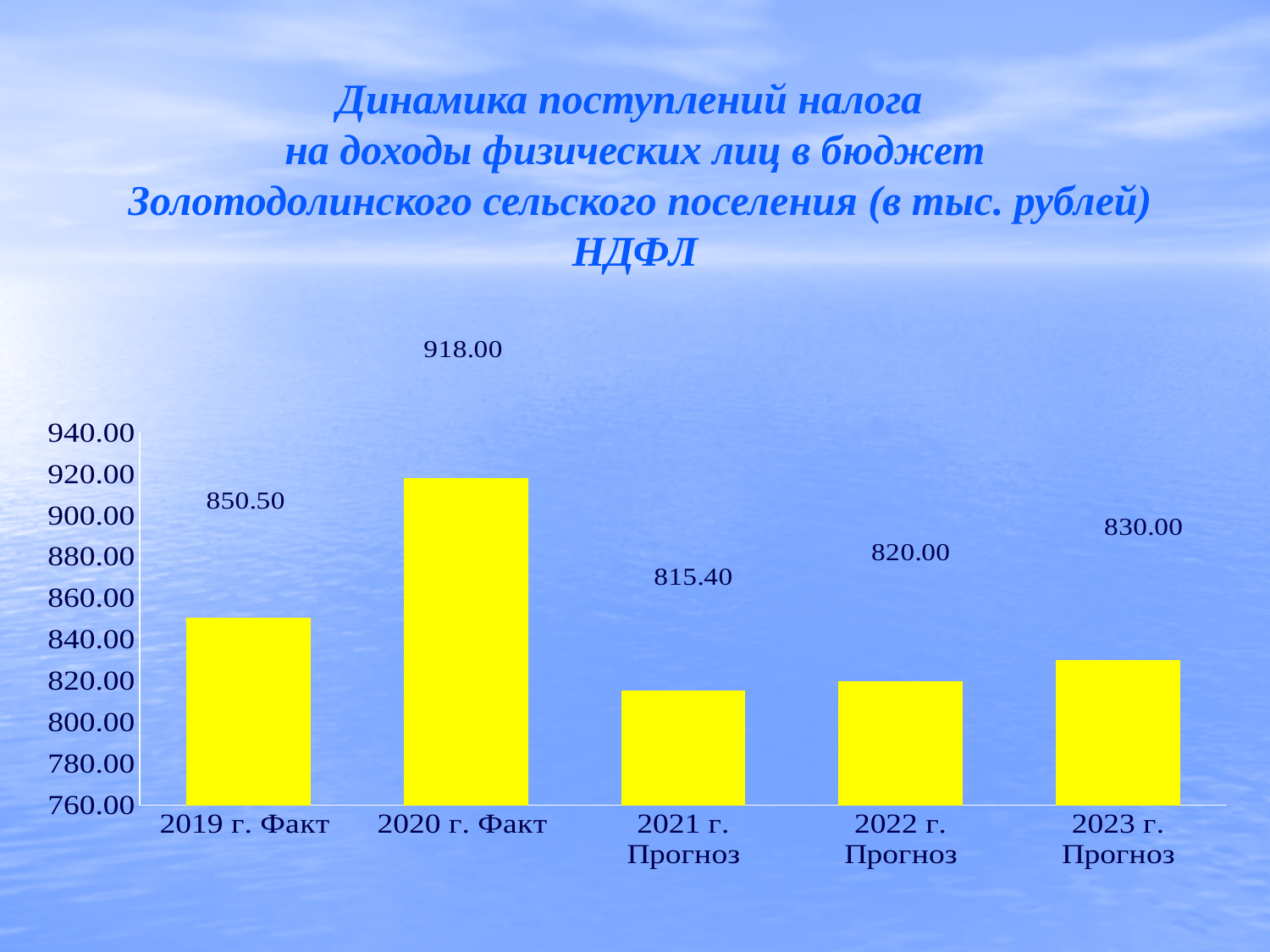
Which is larger, the value for 2019 г. Факт or the value for 2022 г. Прогноз? 2019 г. Факт Which category has the highest value? 2020 г. Факт How many categories are shown on the x axis? 5 What is the difference between the values for 2023 г. Прогноз and 2022 г. Прогноз? 10.00 What colour are the bars in the chart? yellow What is the value for 2020 г. Факт? 918.00 What kind of chart is shown on the slide? bar chart What is the difference between the values for 2020 г. Факт and 2019 г. Факт? 67.50 What is the value for 2019 г. Факт? 850.50 Which category has the lowest value? 2021 г. Прогноз What is the value for 2023 г. Прогноз? 830.00 What is the value for 2021 г. Прогноз? 815.40